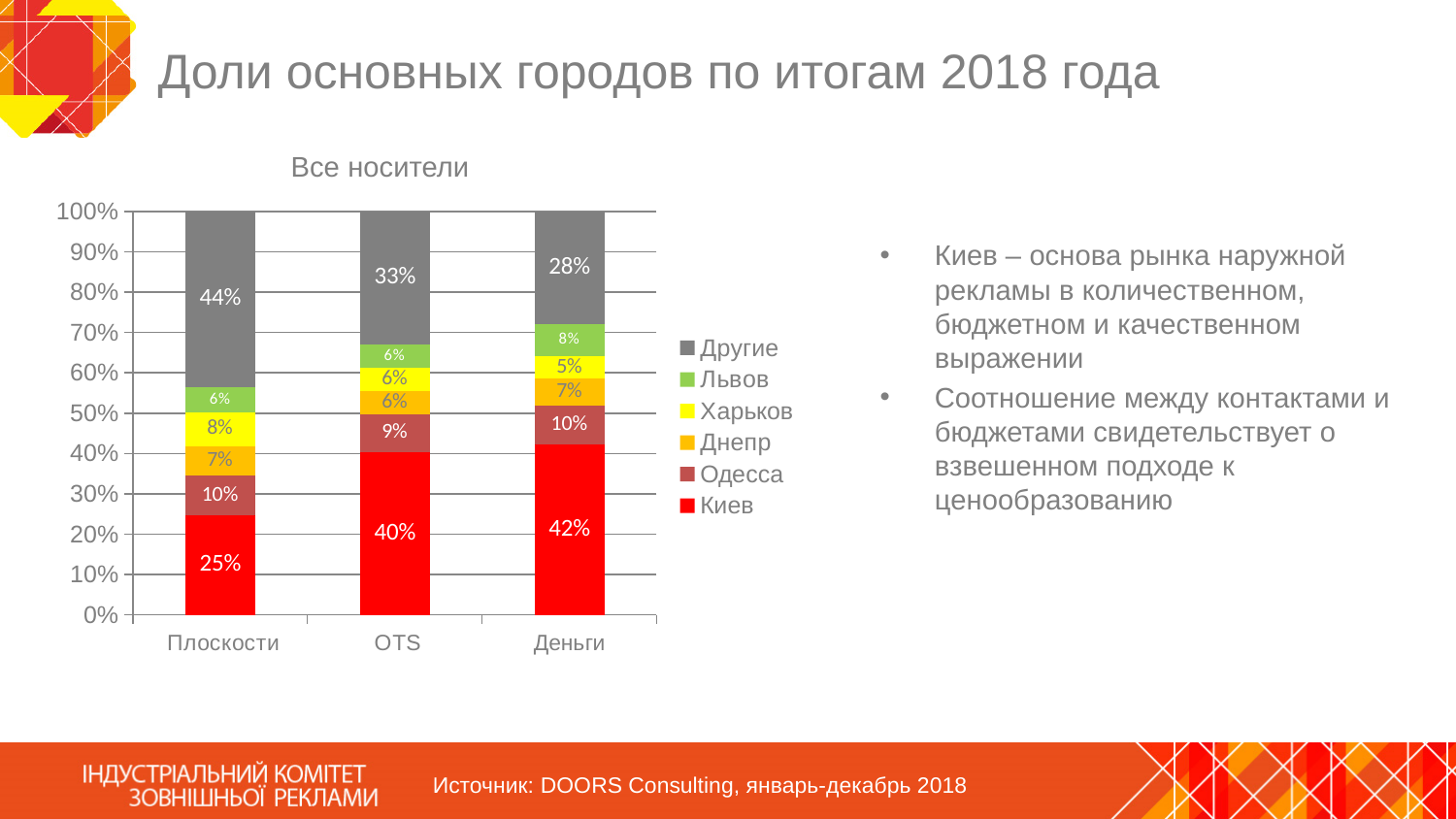
What is the value for Одесса in the Деньги bar? 10% In which category is the Другие share lowest? Деньги In which category is the Киев share highest? Деньги What is the title of the chart? Все носители Which is larger: the Другие value for Плоскости or for Деньги? Плоскости How many categories are shown on the x axis? 3 What is the difference between the Киев values for OTS and Плоскости? 15% What is the value for Львов in the Деньги bar? 8% How many series does the legend list? 6 What is the value for Другие in the OTS bar? 33% What is the value for Киев in the Плоскости bar? 25% What kind of chart is shown on the slide? Stacked bar chart